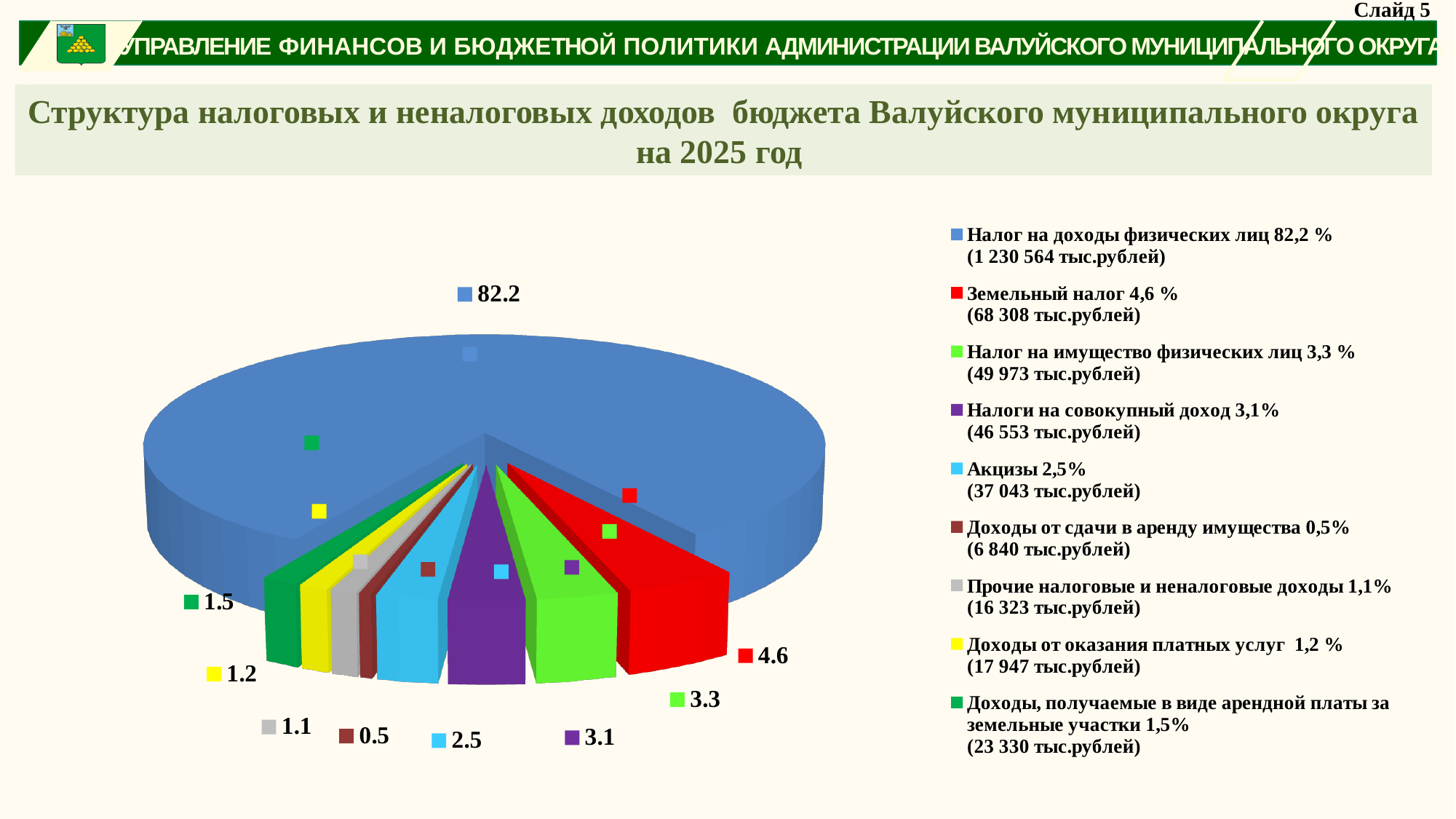
What is the share of Акцизы in the pie chart? 2.5 What is the difference between the shares of Налог на доходы физических лиц and Земельный налог? 77.6 What kind of chart is shown on the slide? pie chart Which is larger: the share of Доходы, получаемые в виде арендной платы за земельные участки or the share of Доходы от оказания платных услуг? Доходы, получаемые в виде арендной платы за земельные участки According to the legend, what amount in thousand rubles corresponds to Земельный налог? 68 308 тыс.рублей What is the share of Налог на доходы физических лиц in the pie chart? 82.2 What is the share of Земельный налог in the pie chart? 4.6 Which category has the largest slice in the pie chart? Налог на доходы физических лиц Which category has the smallest slice in the pie chart? Доходы от сдачи в аренду имущества What is the share of Доходы от сдачи в аренду имущества in the pie chart? 0.5 How many slices does the pie chart have? 9 What colour is the slice for Налоги на совокупный доход? purple